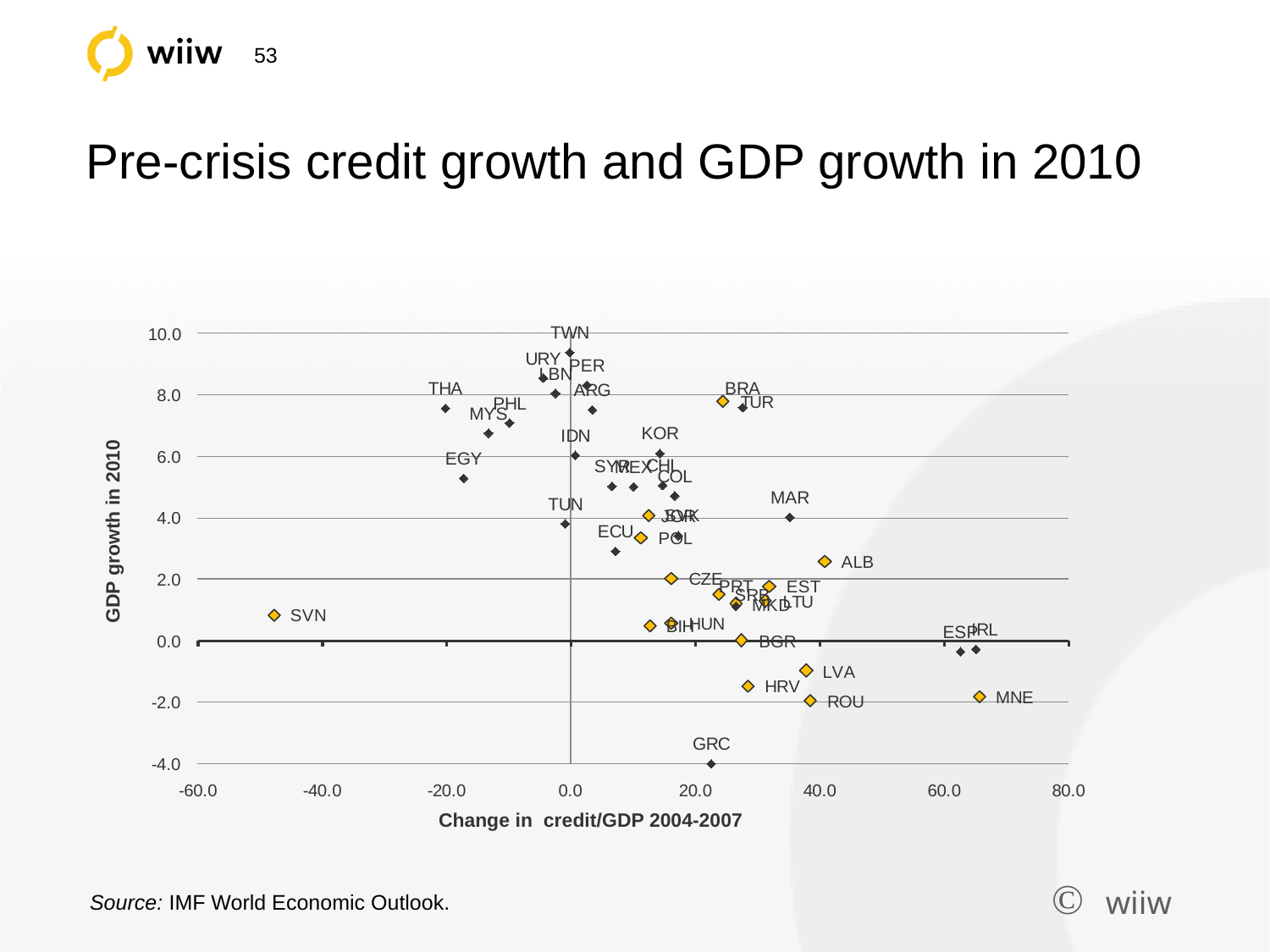
Is the GDP growth in 2010 for GRC greater or less than -2.0? less What is the label of the x axis? Change in credit/GDP 2004-2007 Which country has the highest GDP growth in 2010 on the chart? TWN Which country has the lowest change in credit/GDP 2004-2007 on the chart? SVN Which country has the lowest GDP growth in 2010 on the chart? GRC Is the change in credit/GDP 2004-2007 for SVN greater or less than -40.0? less Which has the higher GDP growth in 2010, BRA or EGY? BRA Is the GDP growth in 2010 for BRA greater or less than 6.0? greater Which country has the highest change in credit/GDP 2004-2007 on the chart? MNE What is the title of the chart? Pre-crisis credit growth and GDP growth in 2010 What kind of chart is shown on the slide? scatter chart